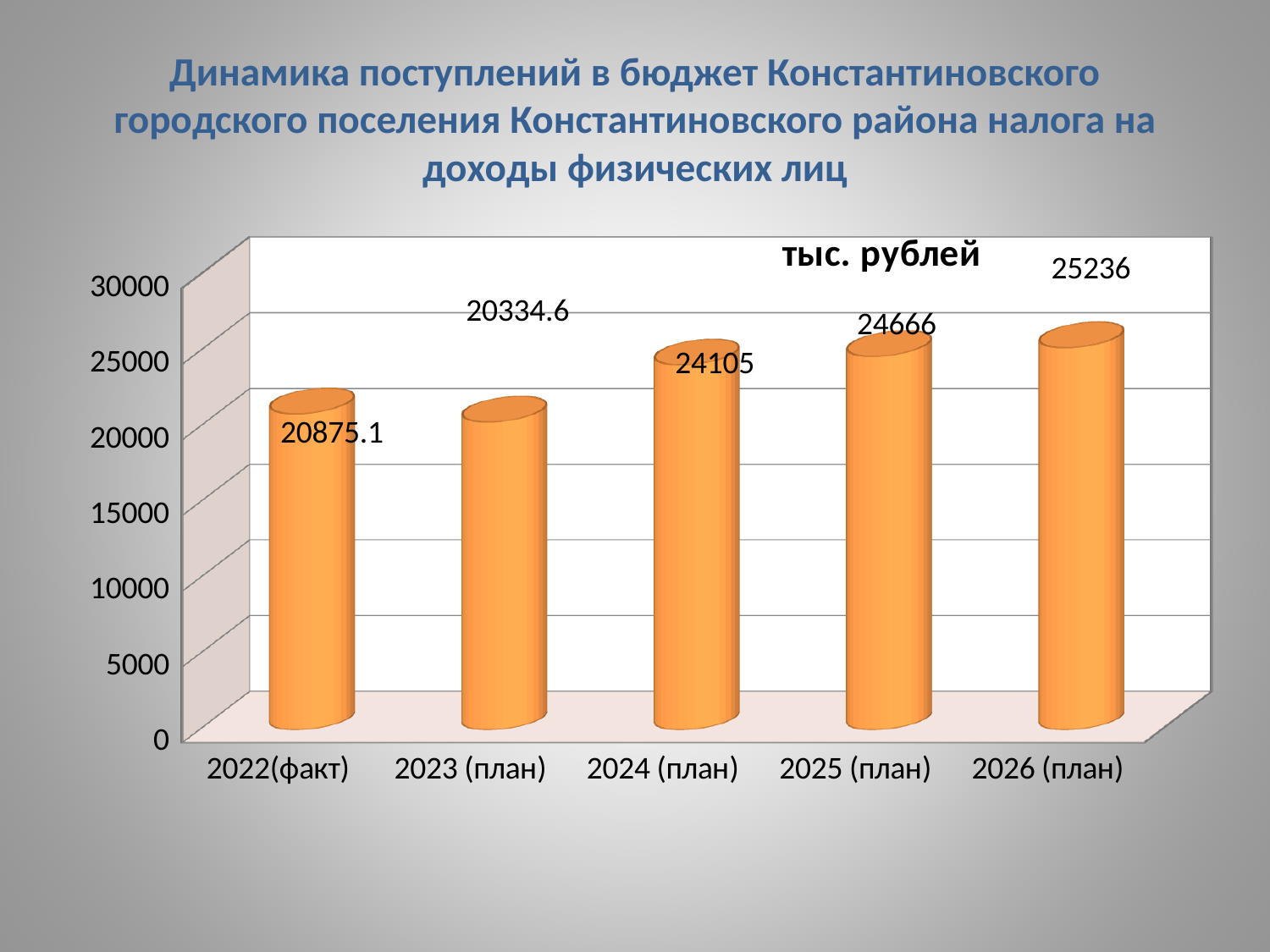
Which is larger, the value for 2024 (план) or the value for 2025 (план)? 2025 (план) Is the value for 2022(факт) greater or less than 25000? less What kind of chart is shown on the slide? bar chart How many categories are shown on the x axis? 5 What is the value for 2026 (план)? 25236 Which category has the lowest value? 2023 (план) What is the value for 2022(факт)? 20875.1 What is the difference between the values for 2026 (план) and 2025 (план)? 570 What is the value for 2024 (план)? 24105 What is the difference between the values for 2022(факт) and 2023 (план)? 540.5 Which category has the highest value? 2026 (план) Do the values rise or fall from 2023 (план) to 2026 (план)? rise